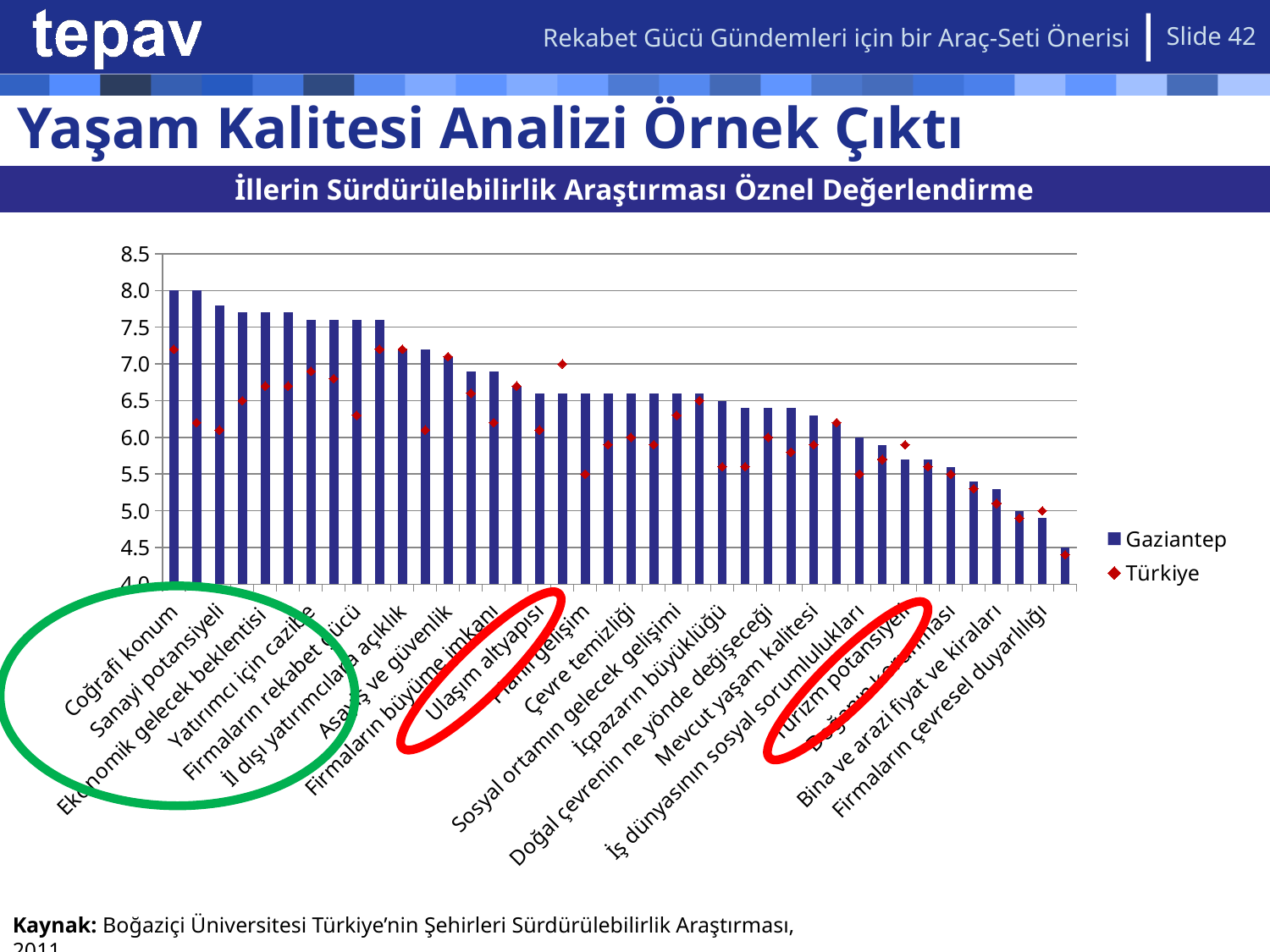
How many series does the legend list? 2 Is the Gaziantep value for Coğrafi konum greater or less than 7.5? greater Do the Gaziantep bars generally rise or fall from left to right along the x axis? fall For Coğrafi konum, which is larger: the Gaziantep value or the Türkiye value? Gaziantep What is the highest value shown on the vertical axis? 8.5 What kind of chart is shown on the slide? bar chart Is the Türkiye value for Sanayi potansiyeli greater or less than 7.0? less Which two series are listed in the chart legend? Gaziantep and Türkiye Is the Türkiye value for Coğrafi konum greater or less than 7.5? less What is the title shown above the chart? İllerin Sürdürülebilirlik Araştırması Öznel Değerlendirme